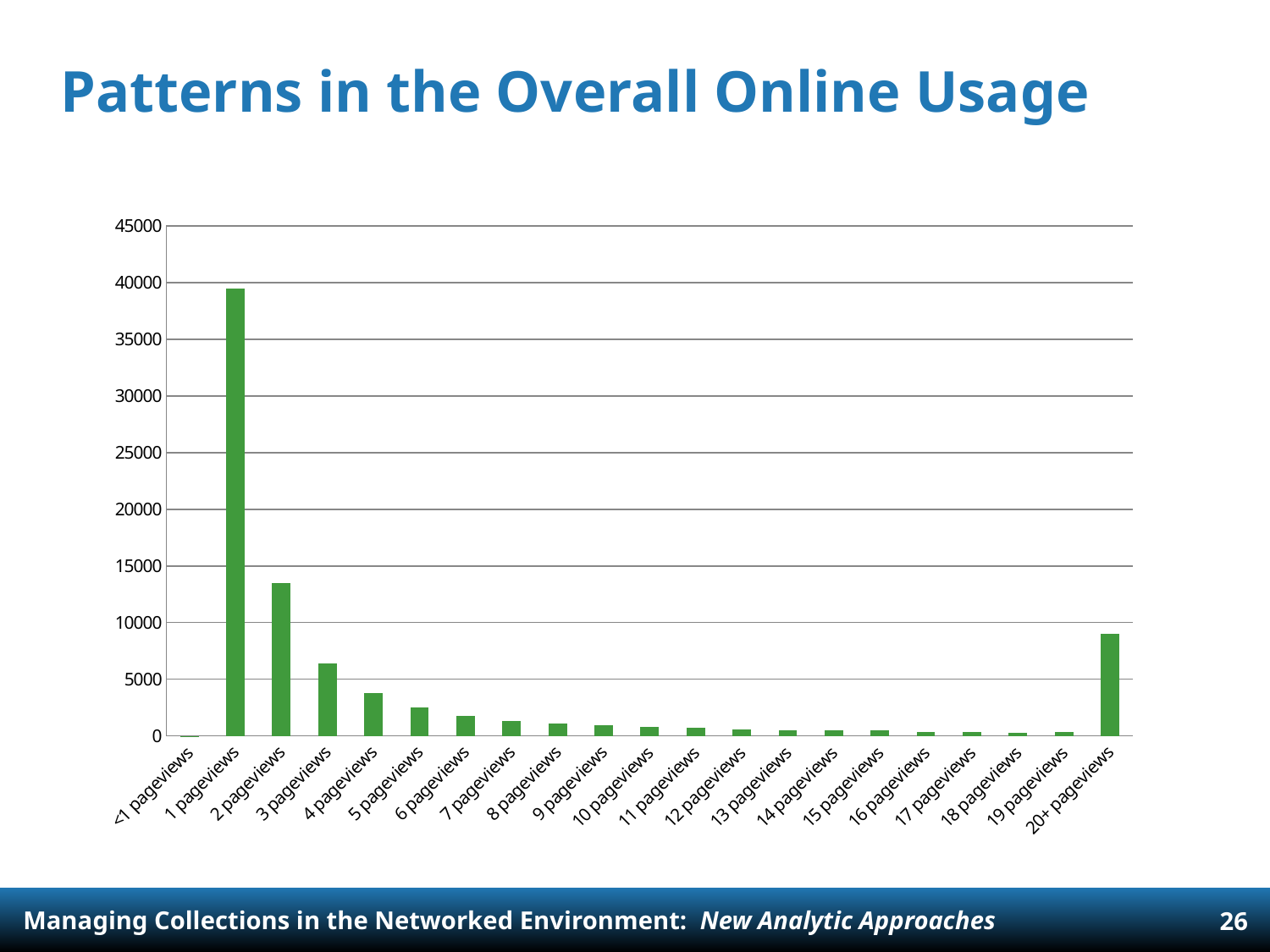
Is the value for 1 pageviews greater or less than 35000? greater Which is larger, the value for 2 pageviews or the value for 20+ pageviews? 2 pageviews What is the title of the slide containing the chart? Patterns in the Overall Online Usage Which category has the highest value? 1 pageviews How many categories are shown along the x axis? 21 Which is larger, the value for 20+ pageviews or the value for 3 pageviews? 20+ pageviews What kind of chart is shown on the slide? bar chart Is the value for 5 pageviews greater or less than 5000? less Is the value for 20+ pageviews greater or less than 5000? greater Do the values rise or fall from 1 pageviews through 19 pageviews? fall